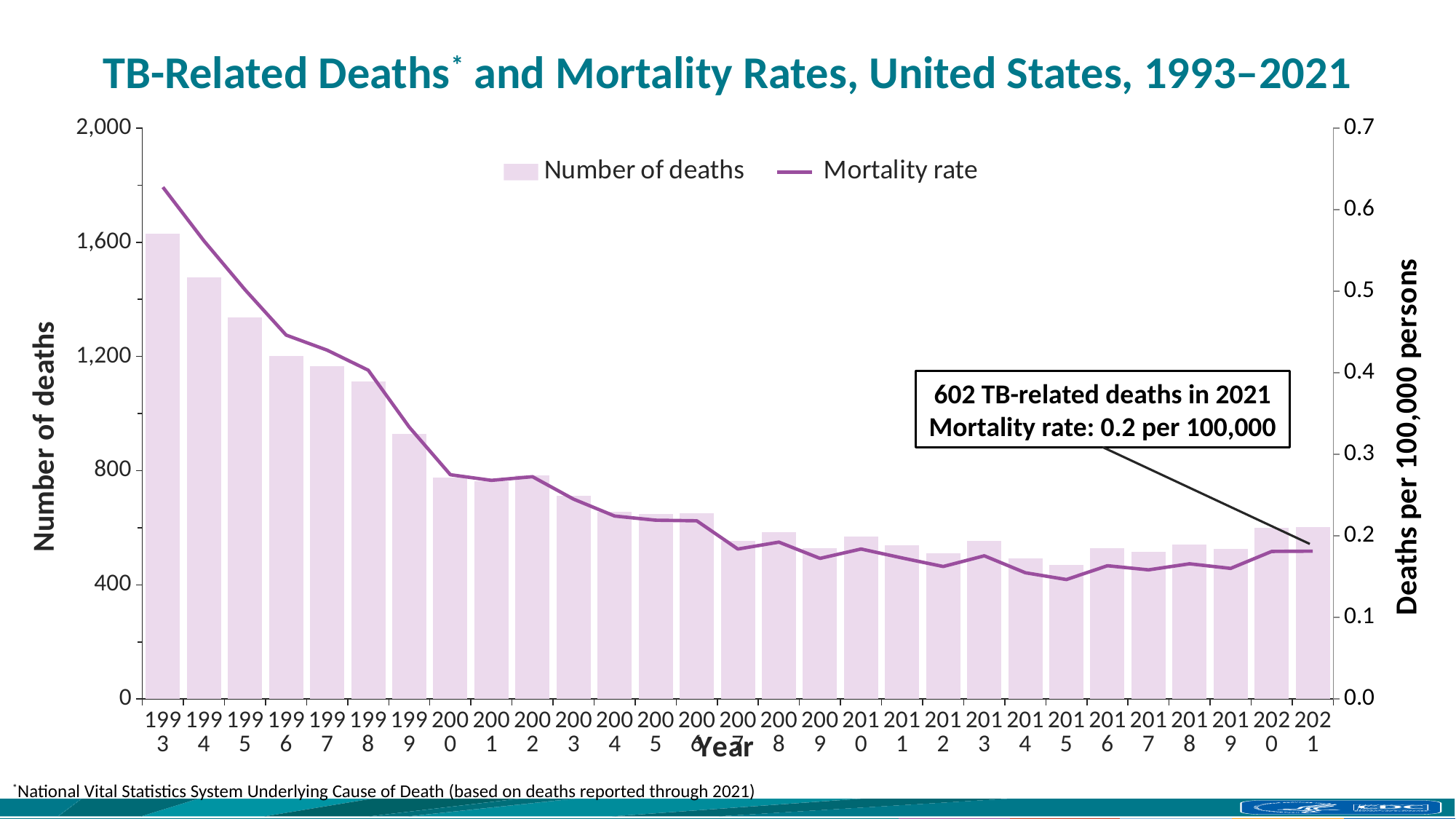
Which year has the highest mortality rate? 1993 What kind of chart is shown on the slide? A combined bar and line chart Which series is drawn as a line rather than bars? Mortality rate How many years are shown on the x axis? 29 Is the number of deaths in 1993 greater or less than 1,200? greater How many series does the legend list? 2 Overall, do the number of deaths rise or fall from 1993 to 2021? Fall How many TB-related deaths were there in 2021? 602 Which year has more deaths, 1993 or 2021? 1993 What was the TB mortality rate in 2021? 0.2 per 100,000 Is the number of deaths in 2005 greater or less than 800? less Which year has the highest number of deaths? 1993